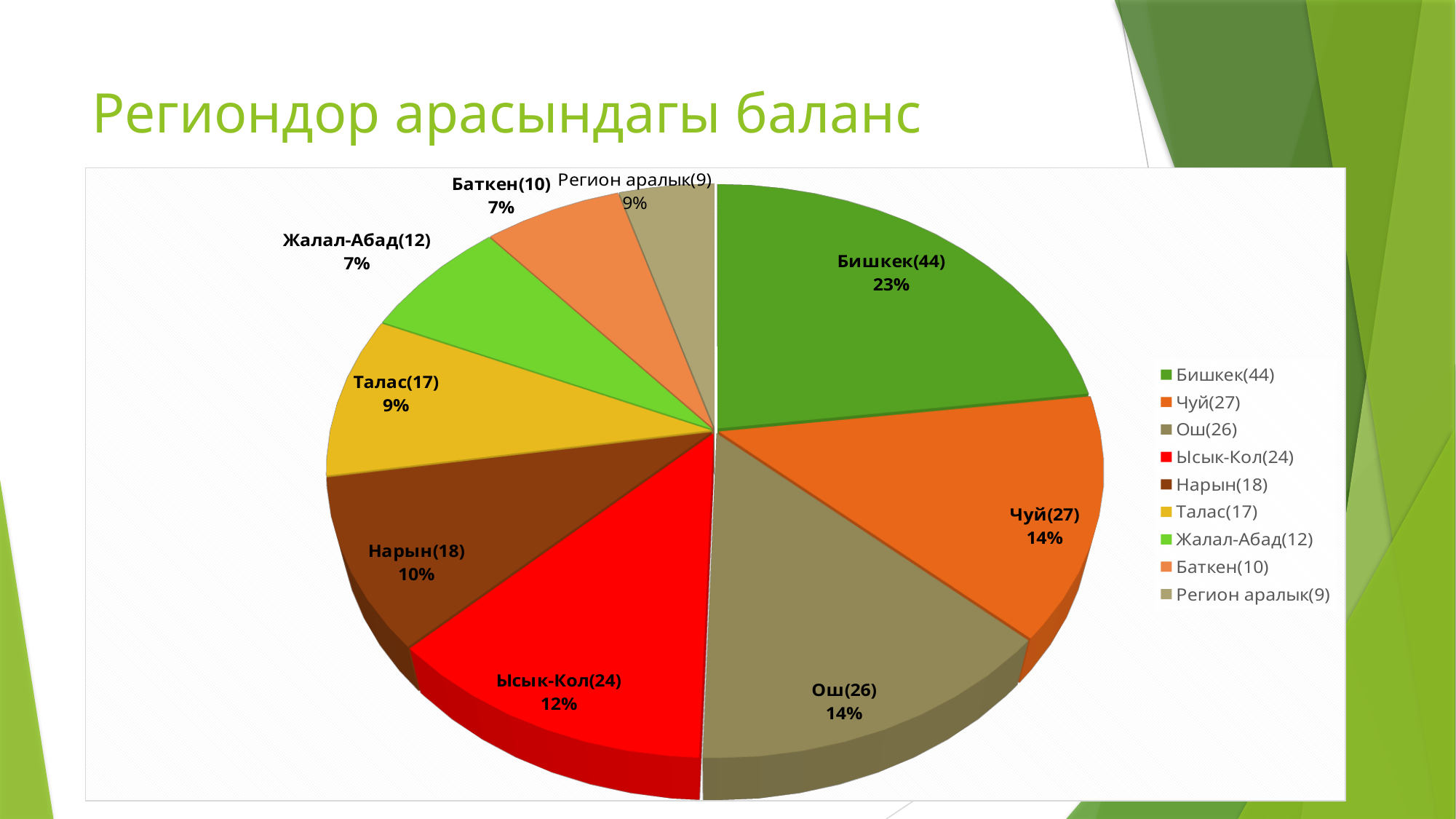
How many slices does the pie chart have? 9 What percentage is shown for the Талас(17) slice? 9% What percentage is shown for the Нарын(18) slice? 10% What is the difference in percentage points between the Бишкек(44) slice and the Ош(26) slice? 9 What is the title of the chart on the slide? Региондор арасындагы баланс Which slice has the largest share of the pie? Бишкек(44) Which is larger, the share for Чуй(27) or the share for Нарын(18)? Чуй(27) What is the difference in percentage points between the Ысык-Кол(24) slice and the Жалал-Абад(12) slice? 5 What percentage is shown for the Ысык-Кол(24) slice? 12% What percentage is shown for the Бишкек(44) slice? 23% What kind of chart is shown on the slide? Pie chart What colour is the Ысык-Кол(24) slice in the legend? Red